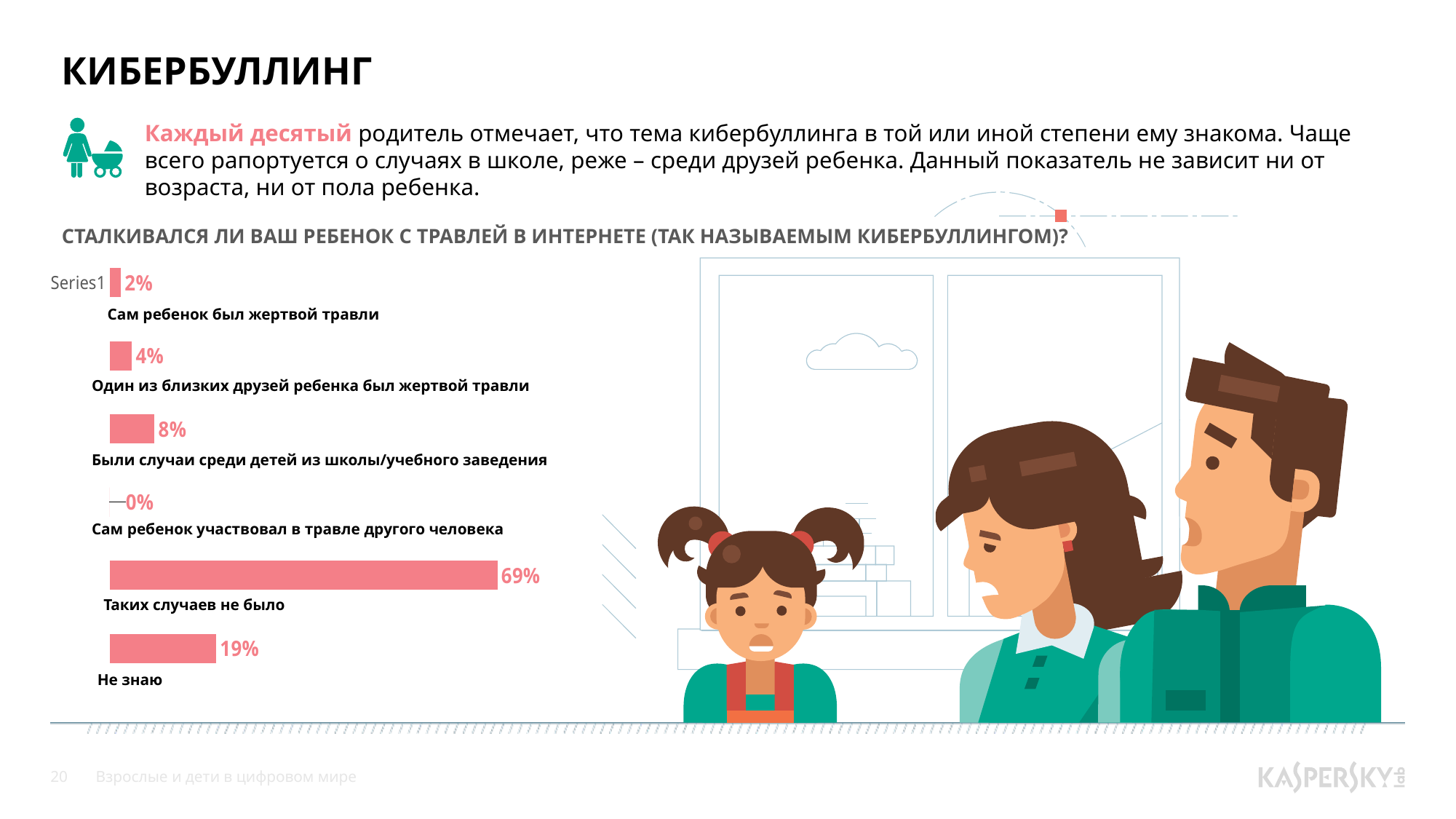
What is the value for "Не знаю"? 19% What type of chart is shown on the slide? Bar chart How many categories are shown in the chart? 6 Which category has the highest value in the chart? Таких случаев не было What is the value for "Сам ребенок был жертвой травли"? 2% What is the difference between "Таких случаев не было" and "Не знаю"? 50% What percentage of parents answered "Таких случаев не было"? 69% What is the value for "Сам ребенок участвовал в травле другого человека"? 0% Which is larger: "Один из близких друзей ребенка был жертвой травли" or "Были случаи среди детей из школы/учебного заведения"? Были случаи среди детей из школы/учебного заведения Which category has the lowest value in the chart? Сам ребенок участвовал в травле другого человека What is the value for "Были случаи среди детей из школы/учебного заведения"? 8%